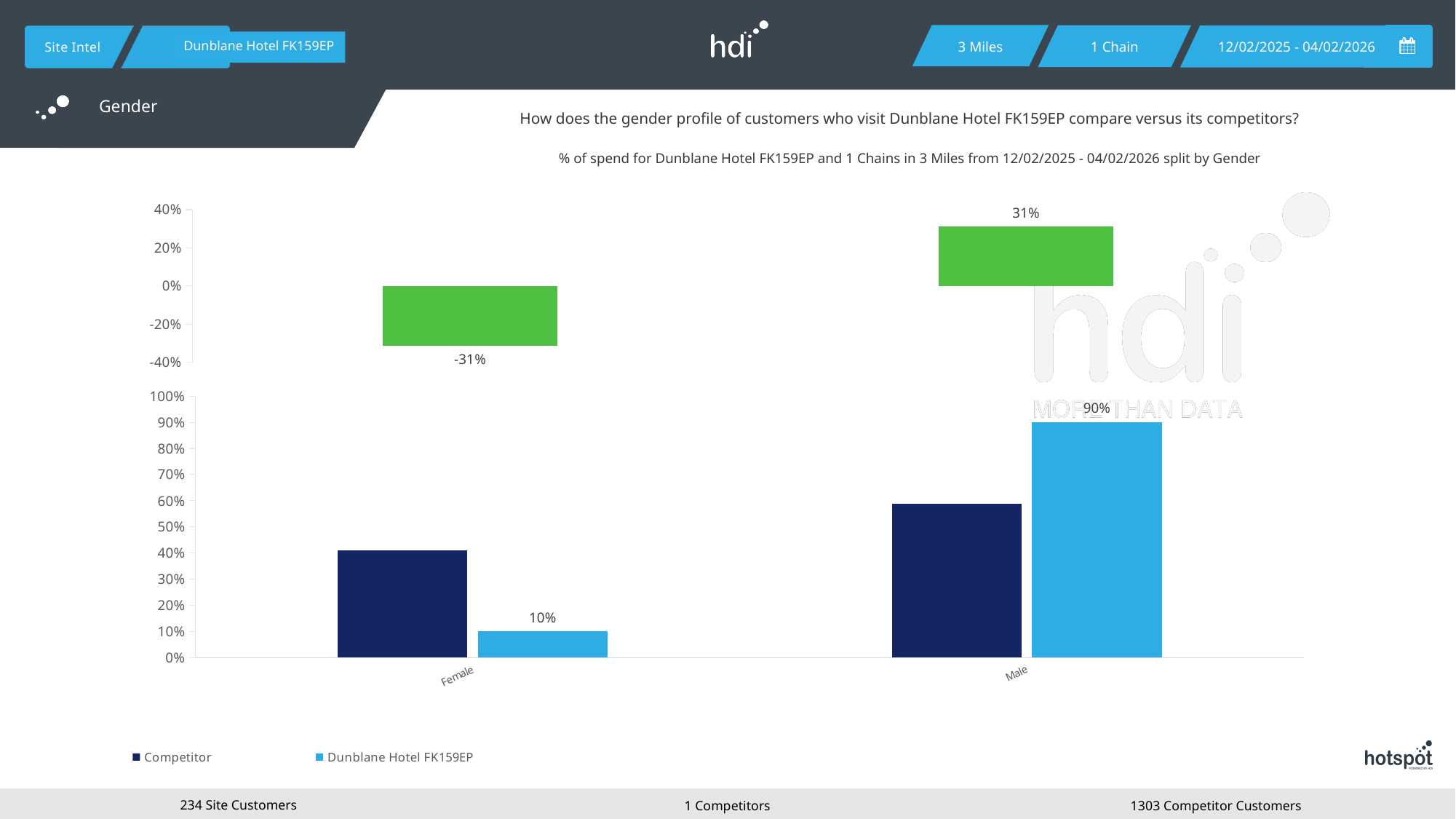
In the bottom chart, is the Competitor value for Male greater or less than 50%? greater In the top chart, what is the value shown for the Female category? -31% How many categories are shown on the x axis of the bottom chart? 2 How many series does the legend of the bottom chart list? 2 In the bottom chart, which category has the higher value for Dunblane Hotel FK159EP? Male In the bottom chart, what is the difference between the Dunblane Hotel FK159EP values for Male and Female? 80% In the bottom chart, is the Competitor value for Female greater or less than 50%? less In the bottom chart, what is the value for Dunblane Hotel FK159EP in the Female category? 10% In the bottom chart, which is larger for the Female category: Competitor or Dunblane Hotel FK159EP? Competitor What kind of chart is the bottom chart? Bar chart In the top chart, what is the value shown for the Male category? 31% In the bottom chart, what is the value for Dunblane Hotel FK159EP in the Male category? 90%